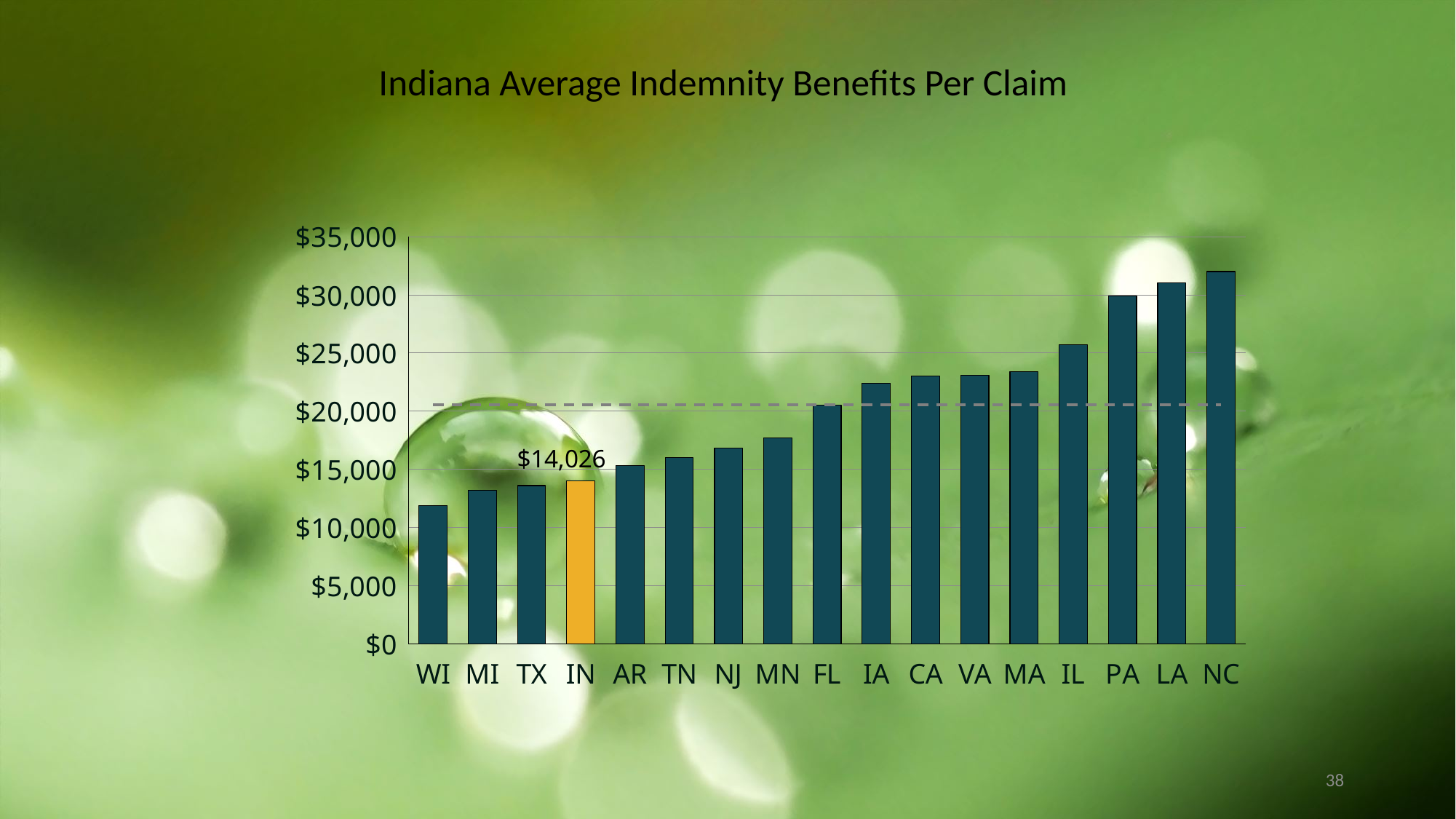
What kind of chart is shown on the slide? bar chart What is the value shown for IN? $14,026 Is the value for MN greater or less than $15,000? greater Which state has the lowest average indemnity benefit per claim? WI Is the value for NC greater or less than $30,000? greater How many states are shown on the x axis? 17 Is the value for IL greater or less than $25,000? greater Do the values rise or fall moving from left to right along the x axis? rise Which state's bar is highlighted in a different colour (gold) from the others? IN Which is larger, the value for IL or the value for MN? IL Which state has the highest average indemnity benefit per claim? NC